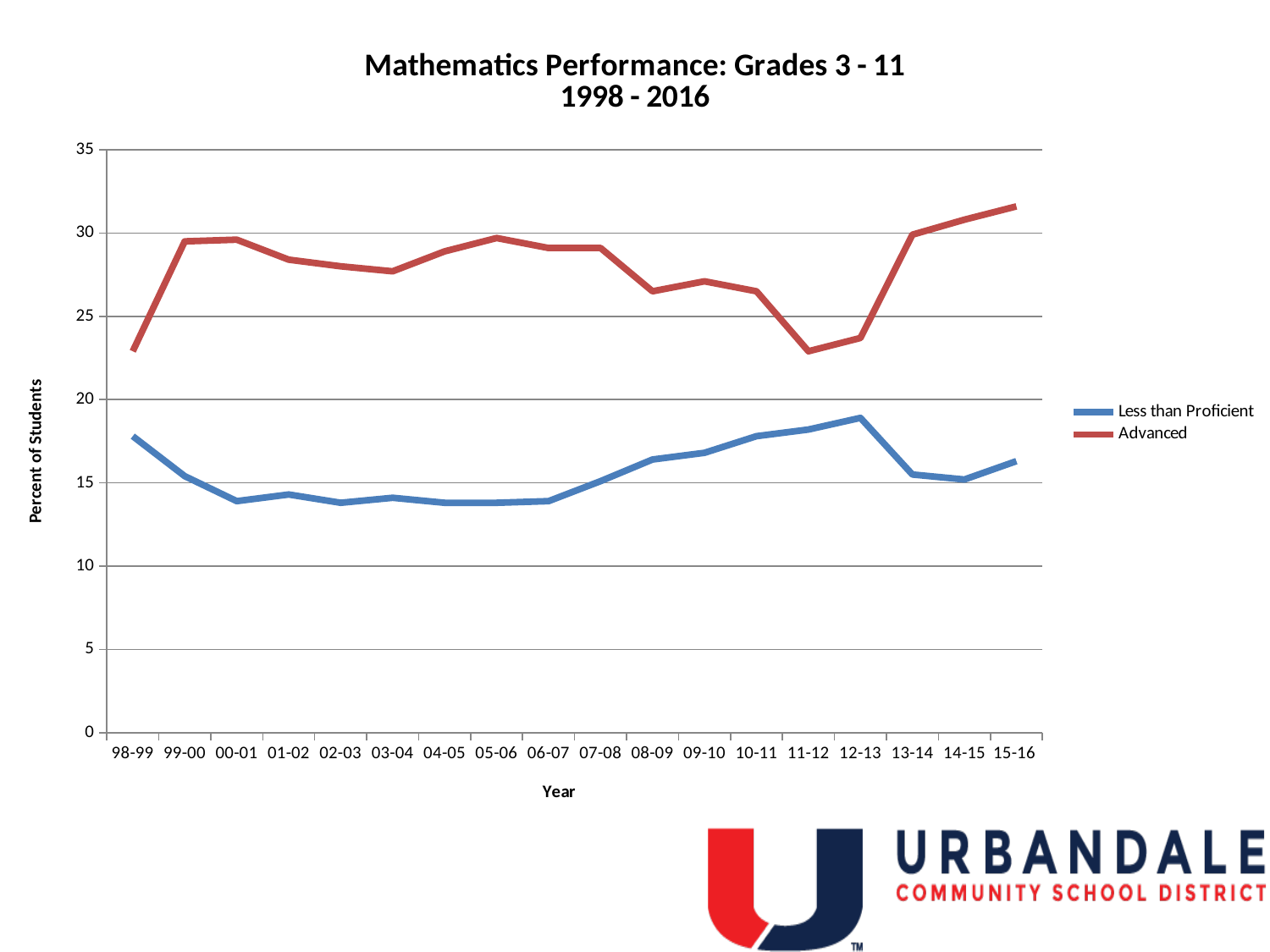
How many series does the legend list? 2 How many years are plotted along the x axis? 18 Does the Advanced series rise or fall from 11-12 to 15-16? Rise Is the Less than Proficient value for 00-01 greater or less than 15? less What kind of chart is shown on the slide? Line chart Which year has the highest value for the Less than Proficient series? 12-13 Is the Advanced value for 15-16 greater or less than 30? greater Is the Advanced value for 11-12 greater or less than 25? less Which series has the larger value in 05-06, Advanced or Less than Proficient? Advanced Which year has the highest value for the Advanced series? 15-16 What is the label on the y axis? Percent of Students